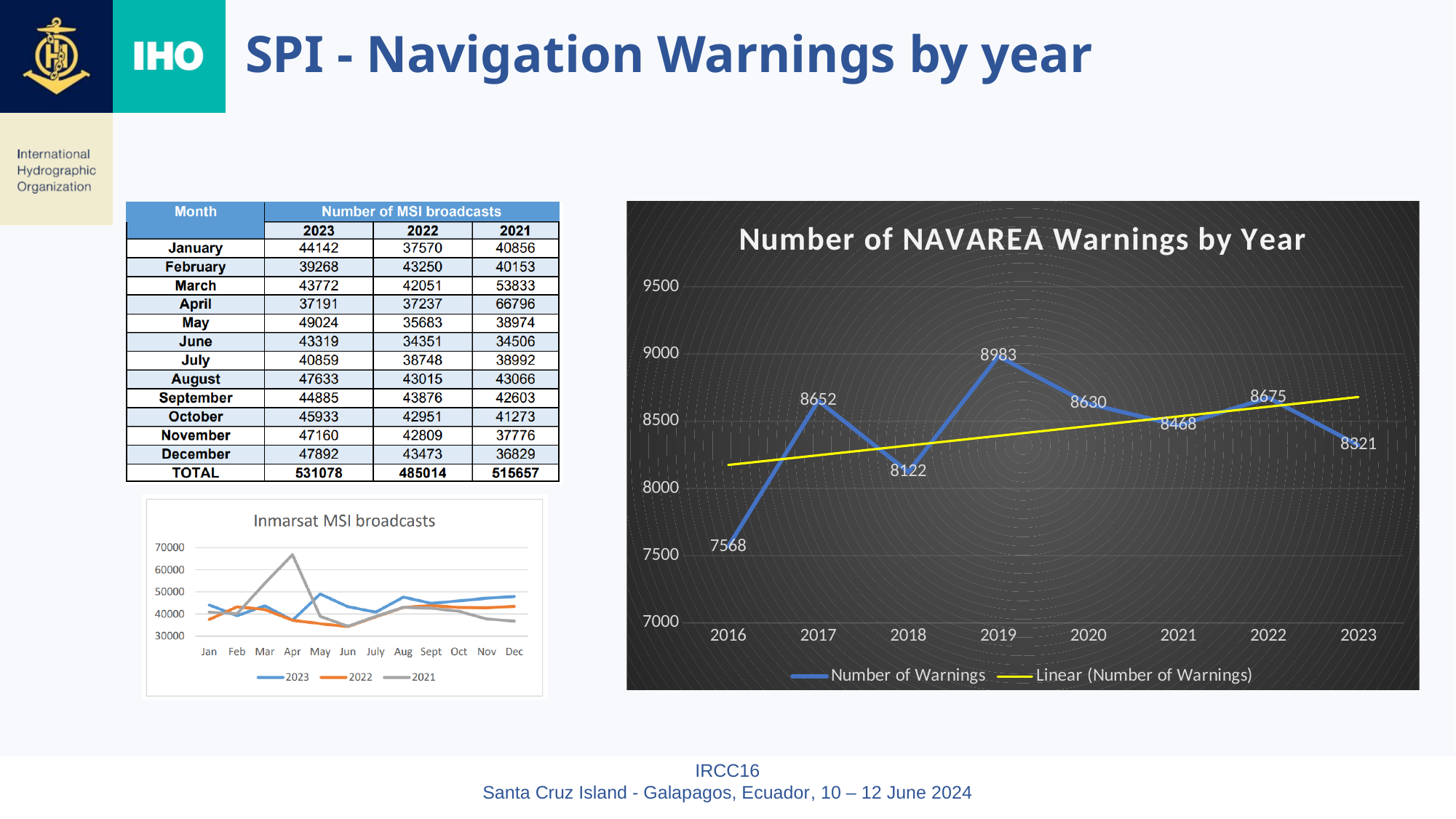
In the 'Inmarsat MSI broadcasts' chart, is the value for 2022 in June greater or less than 40000? less In the 'Number of NAVAREA Warnings by Year' chart, what is the number of warnings for 2019? 8983 What kind of chart is the 'Number of NAVAREA Warnings by Year' chart? line chart How many years are plotted in the 'Number of NAVAREA Warnings by Year' chart? 8 In the 'Number of NAVAREA Warnings by Year' chart, what is the number of warnings for 2016? 7568 In the 'Number of NAVAREA Warnings by Year' chart, which year has more warnings, 2017 or 2022? 2022 In the 'Number of NAVAREA Warnings by Year' chart, which year has the highest number of warnings? 2019 How many series does the legend of the 'Inmarsat MSI broadcasts' chart list? 3 In the 'Inmarsat MSI broadcasts' chart, is the value for 2021 in April greater or less than 60000? greater How many entries does the legend of the 'Number of NAVAREA Warnings by Year' chart list? 2 In the 'Number of NAVAREA Warnings by Year' chart, what is the difference between the 2019 and 2018 values? 861 In the 'Number of NAVAREA Warnings by Year' chart, which year has the lowest number of warnings? 2016